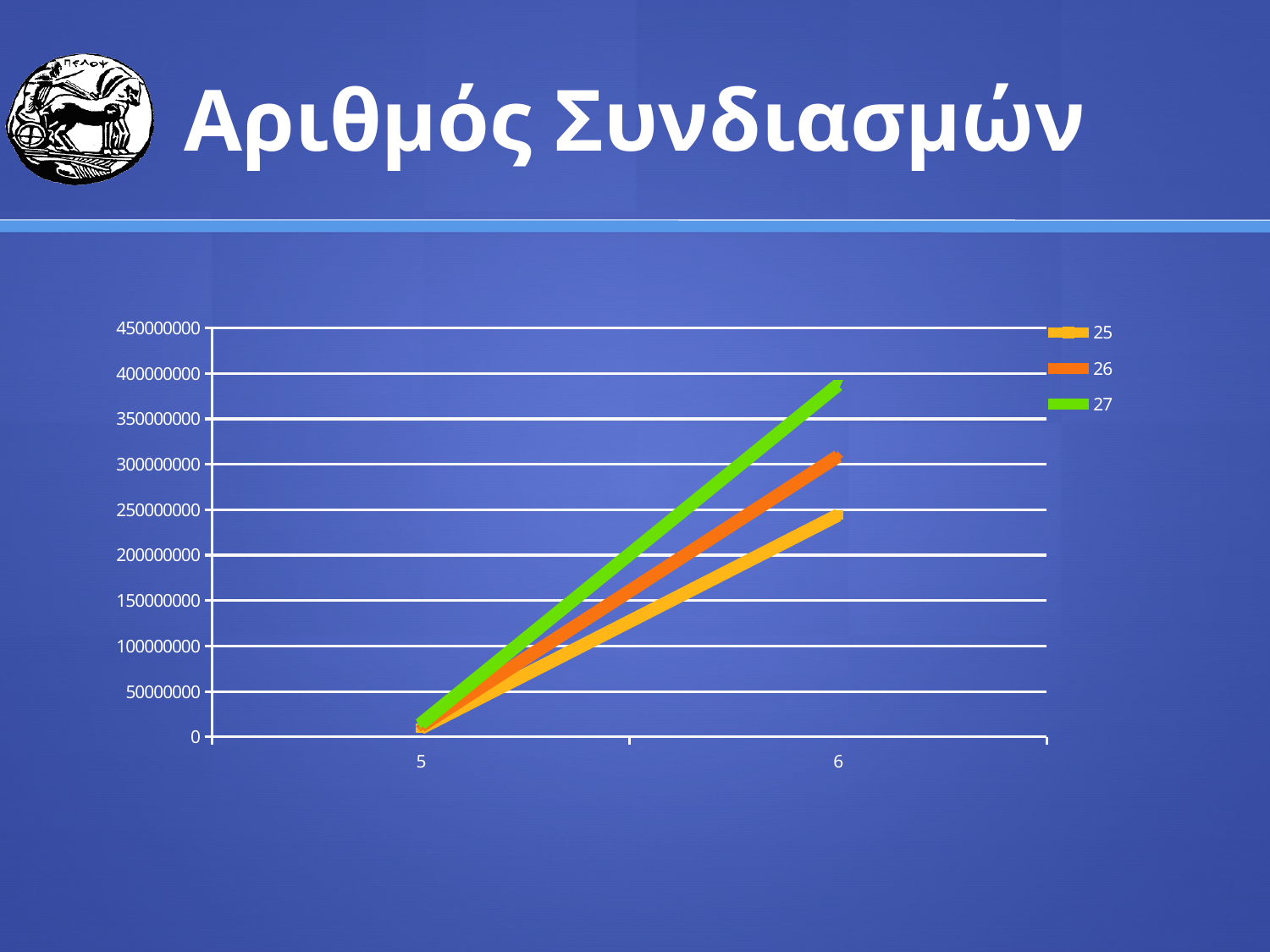
What kind of chart is shown on the slide? line chart How many series does the legend list? 3 Is the value for series 27 at x = 6 greater or less than 350000000? greater Is the value for series 25 at x = 6 greater or less than 300000000? less What colour is the line for series 27 in the legend? green Do the values of series 27 rise or fall from x = 5 to x = 6? rise Is the value for series 26 at x = 6 greater or less than 250000000? greater At x = 6, which series has the larger value, 26 or 25? 26 Which series has the lowest value at x = 6? 25 How many points are plotted along the x axis? 2 Which series has the highest value at x = 6? 27